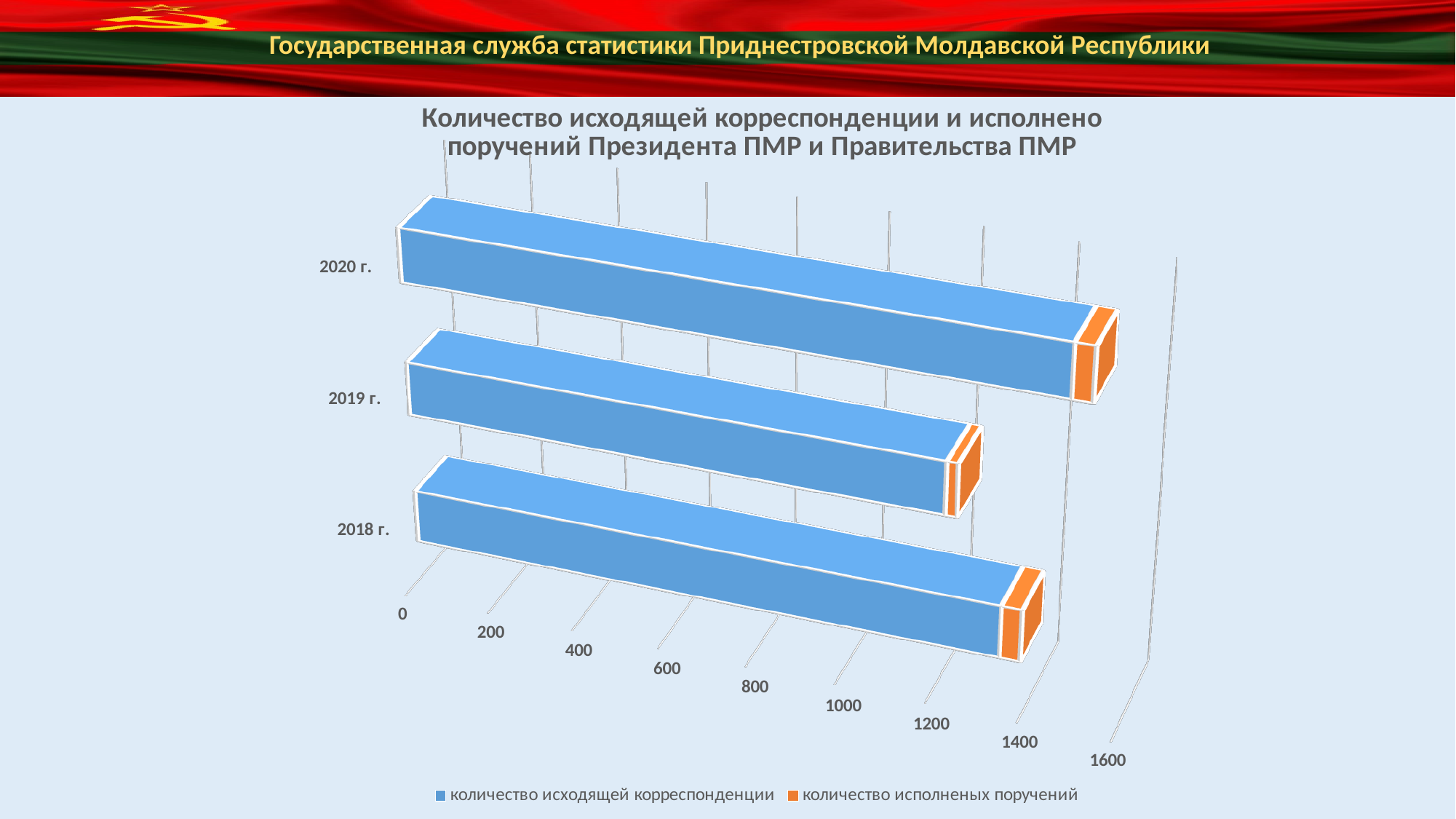
Which year has the lowest value for количество исходящей корреспонденции? 2019 г. Is the value for количество исходящей корреспонденции in 2020 г. greater or less than 1200? greater Is the value for количество исходящей корреспонденции in 2019 г. greater or less than 1400? less What kind of chart is shown on the slide? bar chart What is the maximum value shown on the value axis? 1600 How many series does the legend list? 2 Which year has the highest value for количество исходящей корреспонденции? 2020 г. Is the value for количество исходящей корреспонденции in 2018 г. greater or less than 1600? less How many years (categories) are shown on the chart? 3 Which series is shown in orange in the legend? количество исполненых поручений Which year has the larger value for количество исходящей корреспонденции, 2020 г. or 2018 г.? 2020 г.